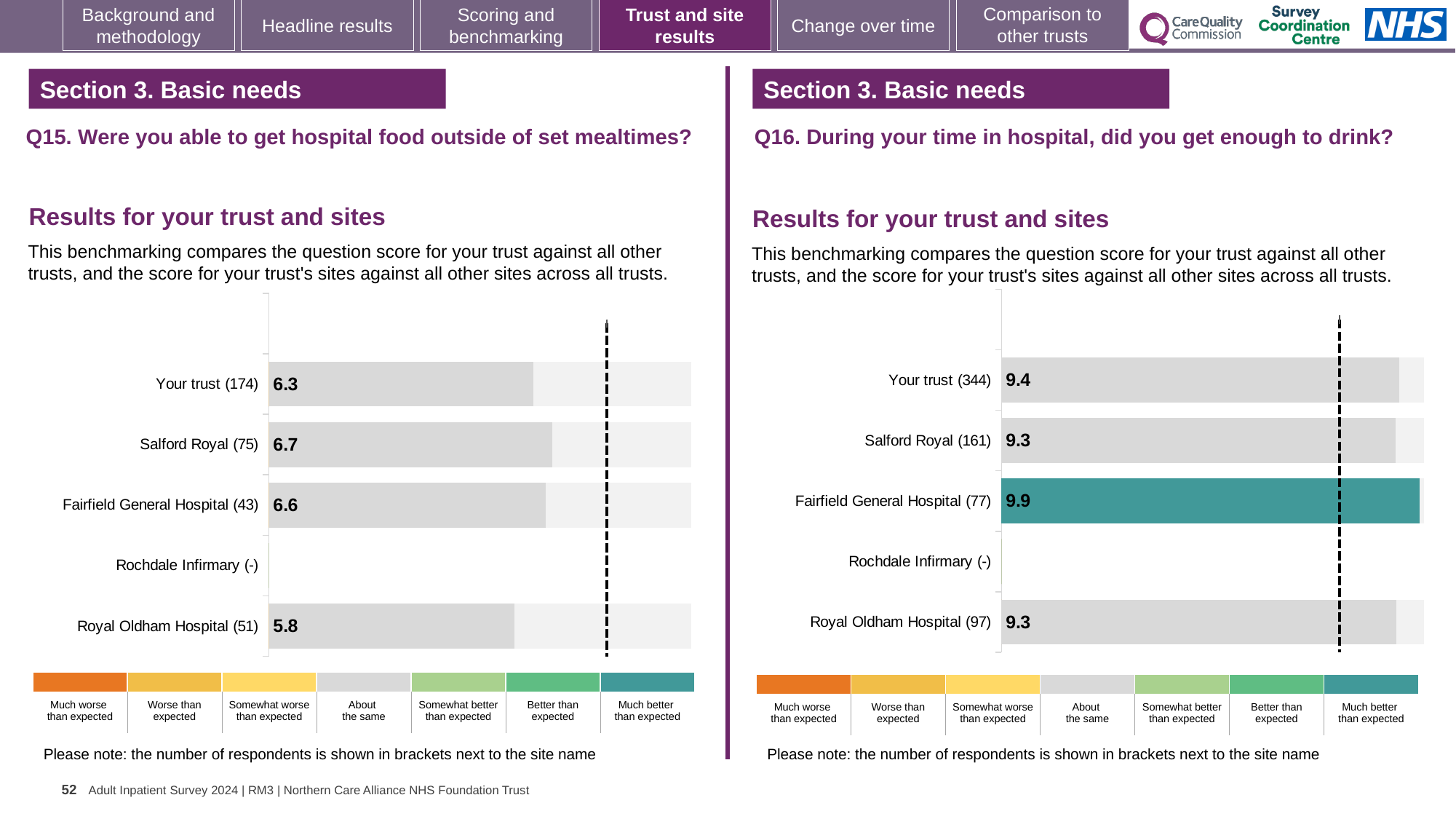
In the Q16 chart on the right, what is the score for Fairfield General Hospital? 9.9 In the Q15 chart on the left, which has the higher score, Fairfield General Hospital or Your trust? Fairfield General Hospital In the Q16 chart on the right, which has the higher score, Your trust or Salford Royal? Your trust In the Q15 chart on the left, what is the score for Your trust? 6.3 In the Q16 chart on the right, which benchmark category does the colour of the Fairfield General Hospital bar correspond to? Much better than expected In the Q15 chart on the left, what is the difference between the scores for Salford Royal and Royal Oldham Hospital? 0.9 How many sites (rows) are listed in the Q15 chart on the left? 5 In the Q16 chart on the right, which site has the highest score? Fairfield General Hospital In the Q15 chart on the left, which site has the highest score? Salford Royal In the Q15 chart on the left, which site has the lowest score? Royal Oldham Hospital In the Q16 chart on the right, what is the difference between the scores for Fairfield General Hospital and Your trust? 0.5 What type of chart is used for the Q16 results on the right? Bar chart